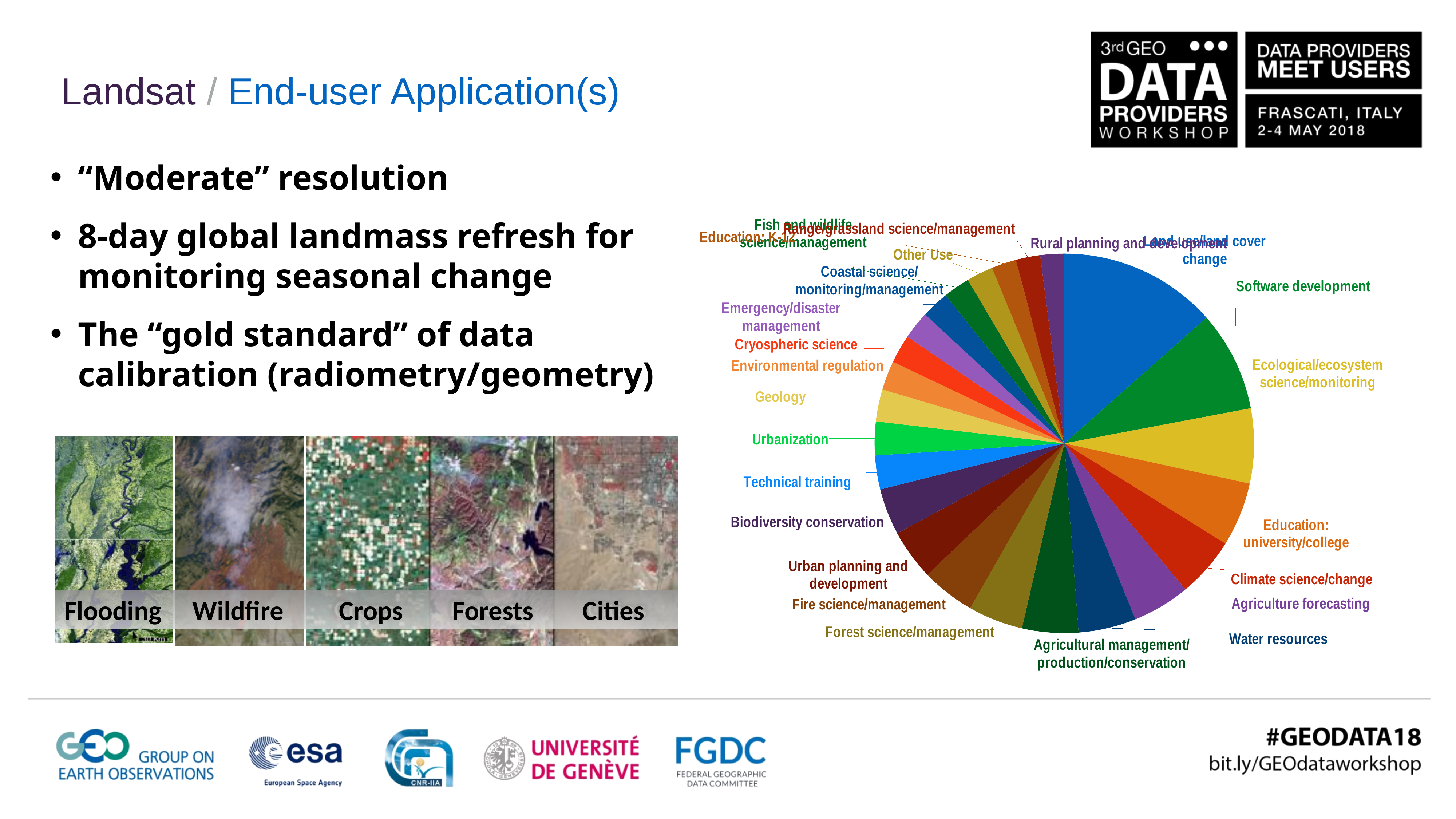
In the pie chart, which slice is larger: Land use/land cover change or Water resources? Land use/land cover change In the pie chart, which slice is larger: Forest science/management or Cryospheric science? Forest science/management What colour is the Land use/land cover change slice in the pie chart? blue What colour is the Software development slice in the pie chart? green Which category has the largest slice in the pie chart? Land use/land cover change In the pie chart, which slice is larger: Agricultural management/production/conservation or Other Use? Agricultural management/production/conservation What kind of chart is shown on the right side of the slide? pie chart